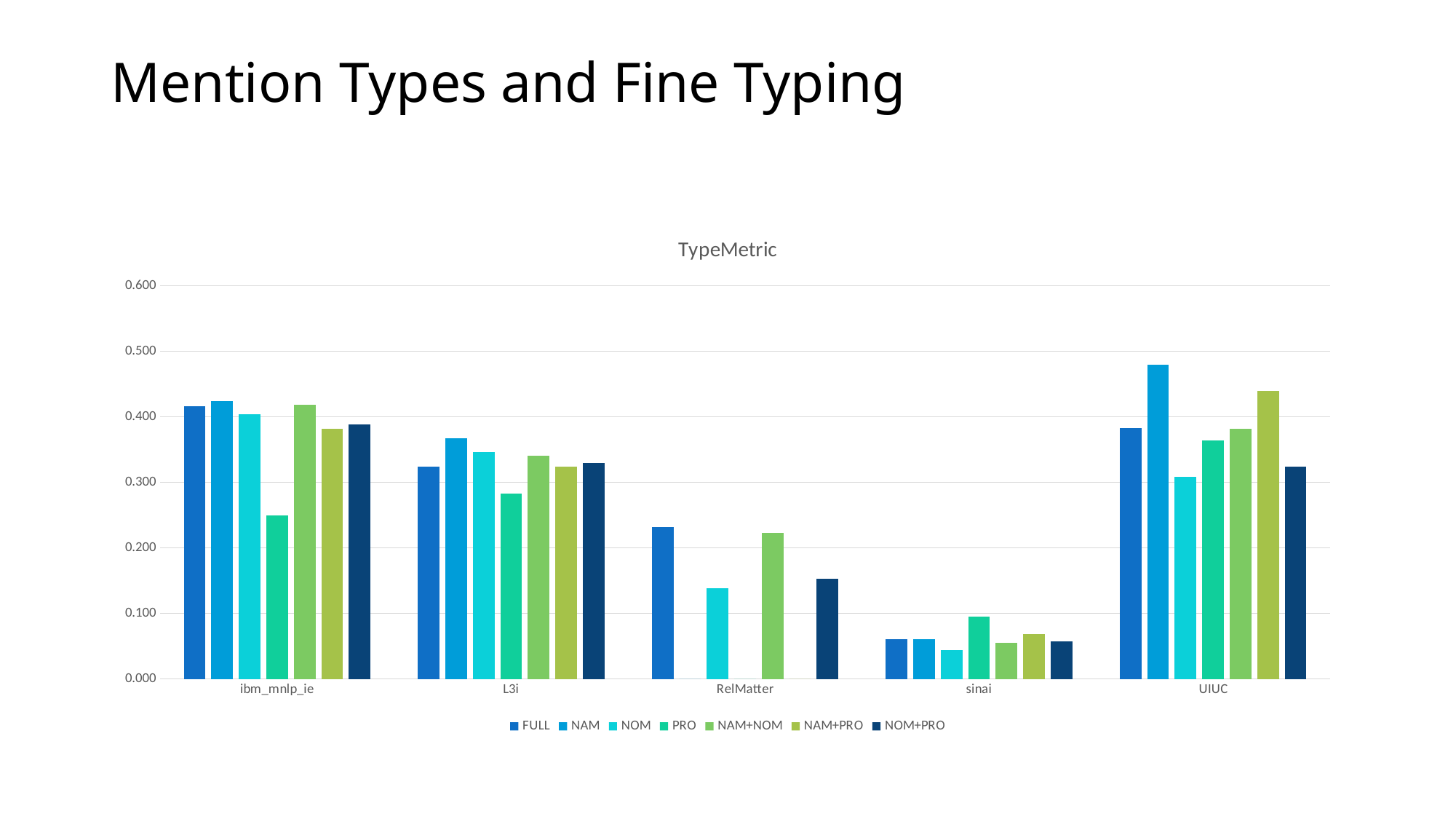
How many categories are shown on the x axis? 5 What is the title of the chart? TypeMetric Which series has the highest value for sinai? PRO Which series has the lowest value for ibm_mnlp_ie? PRO What kind of chart is shown on the slide? bar chart Which series has the lowest value for L3i? PRO Is the value for PRO at ibm_mnlp_ie greater or less than 0.300? less Which is larger, the FULL value for ibm_mnlp_ie or the FULL value for L3i? ibm_mnlp_ie How many series does the legend list? 7 Is the value for FULL at RelMatter greater or less than 0.200? greater Is the value for NAM at UIUC greater or less than 0.400? greater Which series has the highest value for UIUC? NAM